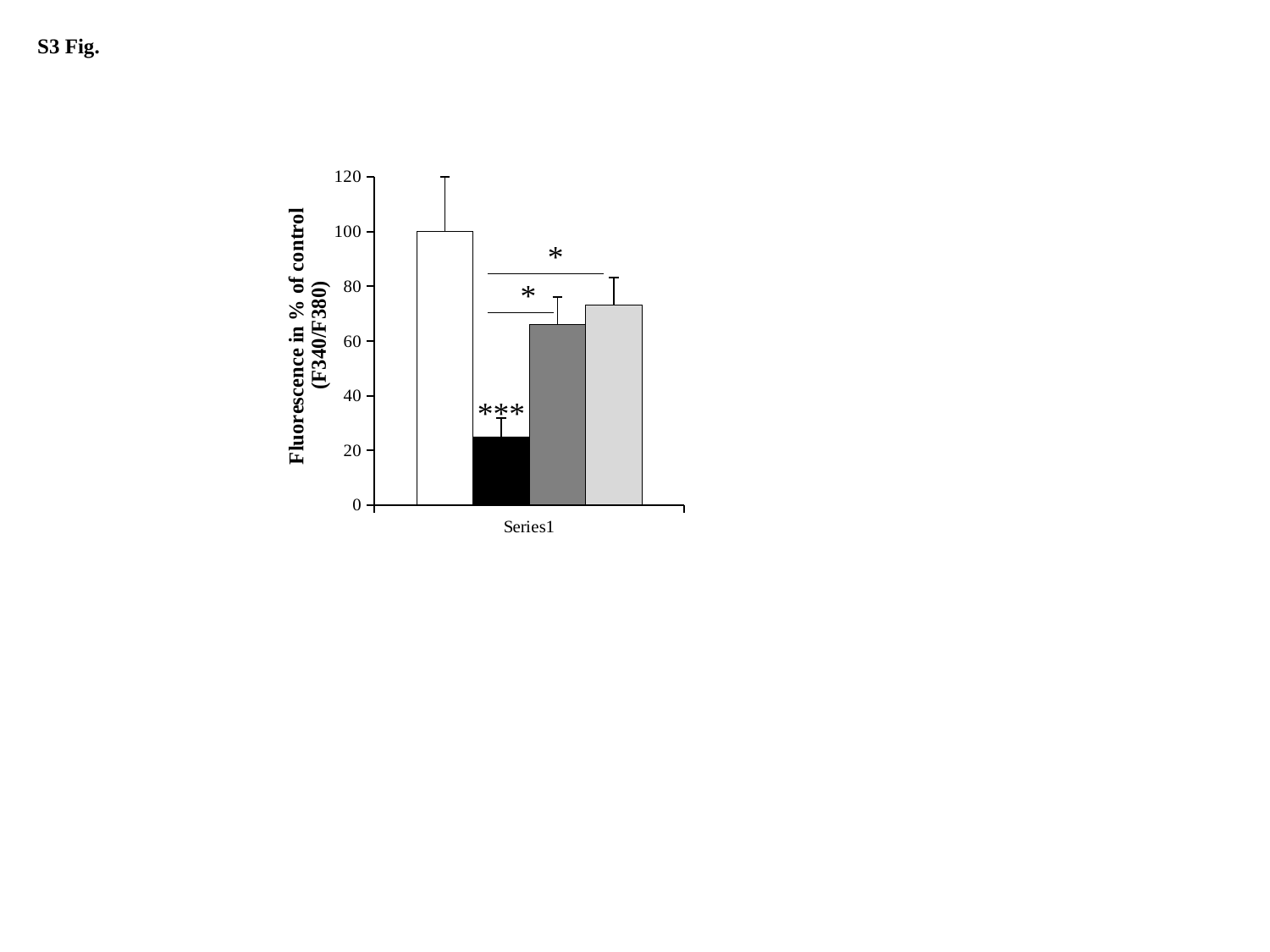
Is the value of the black bar greater or less than 40? less What label is shown on the x axis? Series1 Which is larger, the value of the white bar or the value of the dark gray bar? the white bar Is the value of the light gray bar greater or less than 80? less How many bars are plotted in the chart? 4 What kind of chart is shown on the slide? bar chart What is the value of the white bar? 100 Which is larger, the value of the light gray bar or the value of the black bar? the light gray bar Is the value of the dark gray bar greater or less than 60? greater Which bar is the tallest in the chart? the white bar Which bar is the shortest in the chart? the black bar What is the title of the y axis? Fluorescence in % of control (F340/F380)